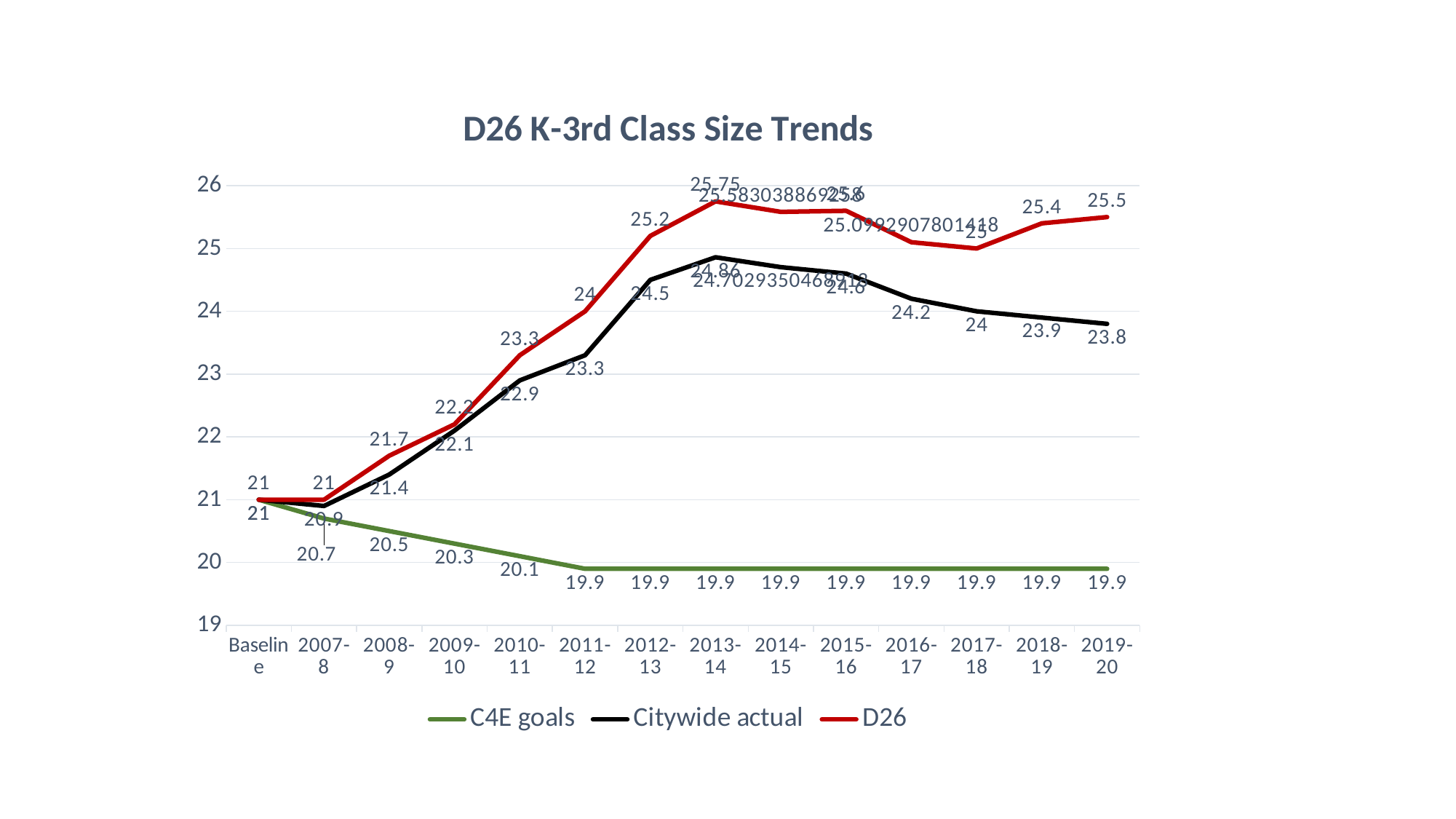
What kind of chart is shown on the slide? line chart How many series does the legend list? 3 Is the Citywide actual value for 2014-15 greater or less than 25? less What is the title of the chart? D26 K-3rd Class Size Trends What is the D26 value for 2019-20? 25.5 In 2018-19, which is larger: the D26 value or the Citywide actual value? D26 In which year does the D26 series reach its highest value? 2013-14 Do the C4E goals values rise or fall from Baseline to 2011-12? fall What is the C4E goals value for 2009-10? 20.3 What is the difference between the D26 value and the Citywide actual value in 2019-20? 1.7 How many categories are shown along the x axis? 14 What is the Citywide actual value for 2012-13? 24.5